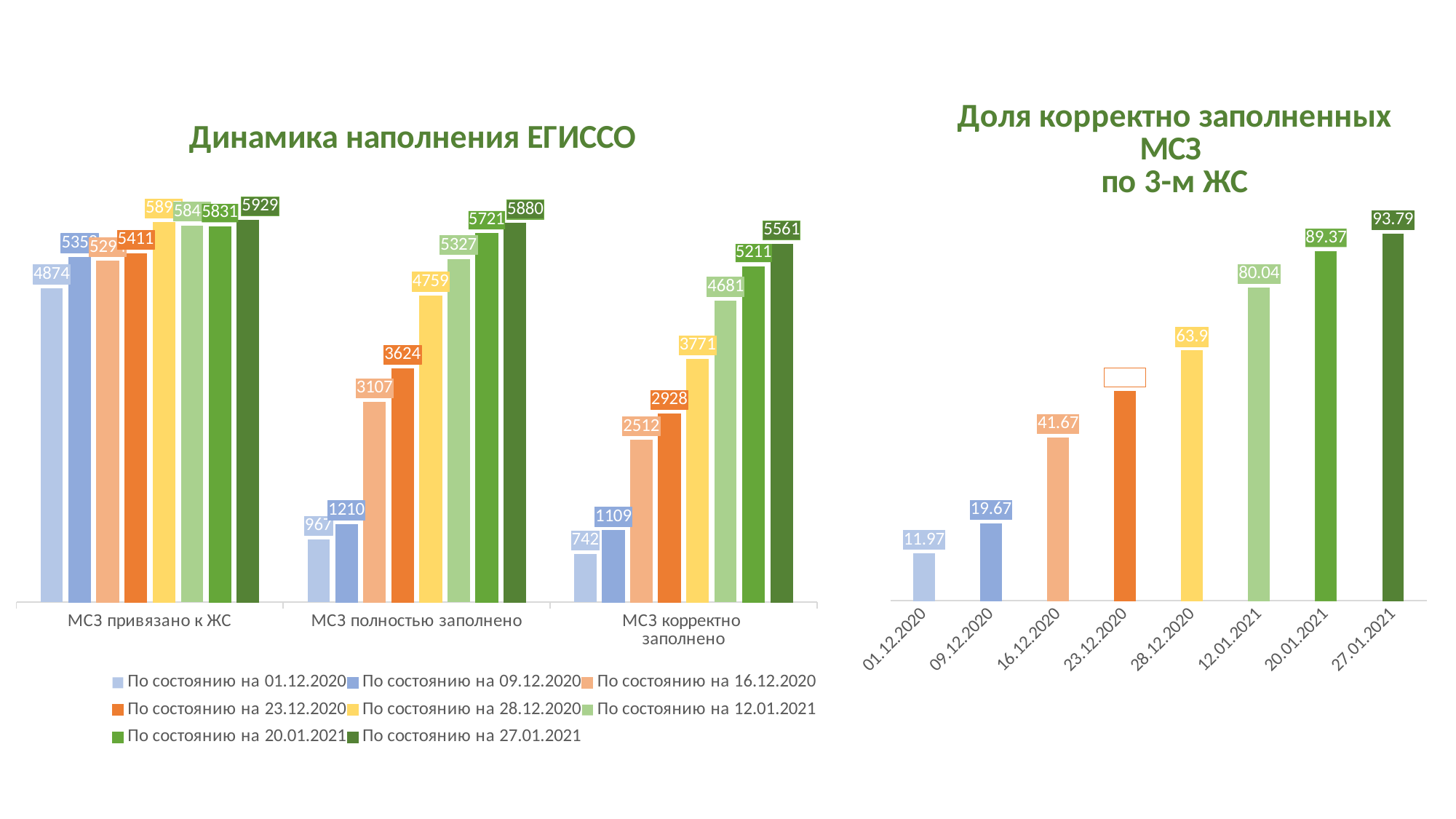
In the 'Доля корректно заполненных МСЗ по 3-м ЖС' chart, which date has the lowest value? 01.12.2020 In the 'Динамика наполнения ЕГИССО' chart, what is the value for 'МСЗ корректно заполнено' as of 01.12.2020? 742 In the 'Динамика наполнения ЕГИССО' chart, what is the difference between the 27.01.2021 and 20.01.2021 values for 'МСЗ корректно заполнено'? 350 How many dates are shown on the x axis of the 'Доля корректно заполненных МСЗ по 3-м ЖС' chart? 8 In the 'Динамика наполнения ЕГИССО' chart, as of 16.12.2020, which is larger: 'МСЗ полностью заполнено' or 'МСЗ корректно заполнено'? МСЗ полностью заполнено How many series does the legend of the 'Динамика наполнения ЕГИССО' chart list? 8 In the 'Динамика наполнения ЕГИССО' chart, what is the value for 'МСЗ полностью заполнено' as of 27.01.2021? 5880 What kind of chart is the 'Динамика наполнения ЕГИССО' chart? bar chart In the 'Доля корректно заполненных МСЗ по 3-м ЖС' chart, do the values rise or fall from 01.12.2020 to 27.01.2021? rise In the 'Динамика наполнения ЕГИССО' chart, what is the value for 'МСЗ привязано к ЖС' as of 27.01.2021? 5929 In the 'Доля корректно заполненных МСЗ по 3-м ЖС' chart, which date has the highest value? 27.01.2021 In the 'Доля корректно заполненных МСЗ по 3-м ЖС' chart, what is the value for 27.01.2021? 93.79